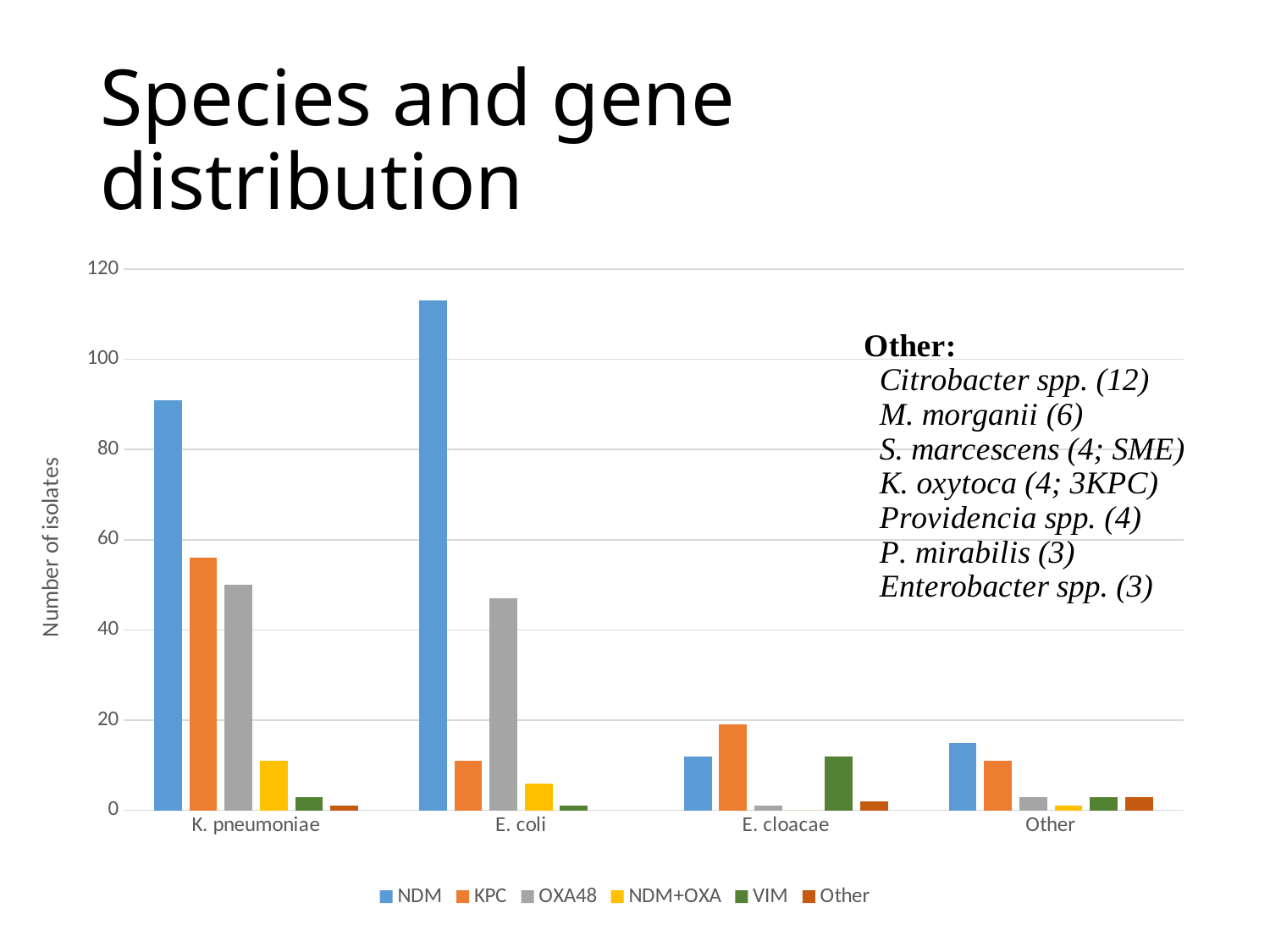
Is the NDM value for E. coli greater or less than 100? greater What kind of chart is shown on the slide? bar chart Which species has the highest NDM bar? E. coli What is the label on the y axis? Number of isolates For E. cloacae, which gene series has the tallest bar? KPC Is the KPC value for K. pneumoniae greater or less than 40? greater Is the NDM value for the Other species category greater or less than 20? less For E. coli, which is larger: the KPC bar or the OXA48 bar? OXA48 How many species categories are shown on the x axis? 4 How many series does the legend list? 6